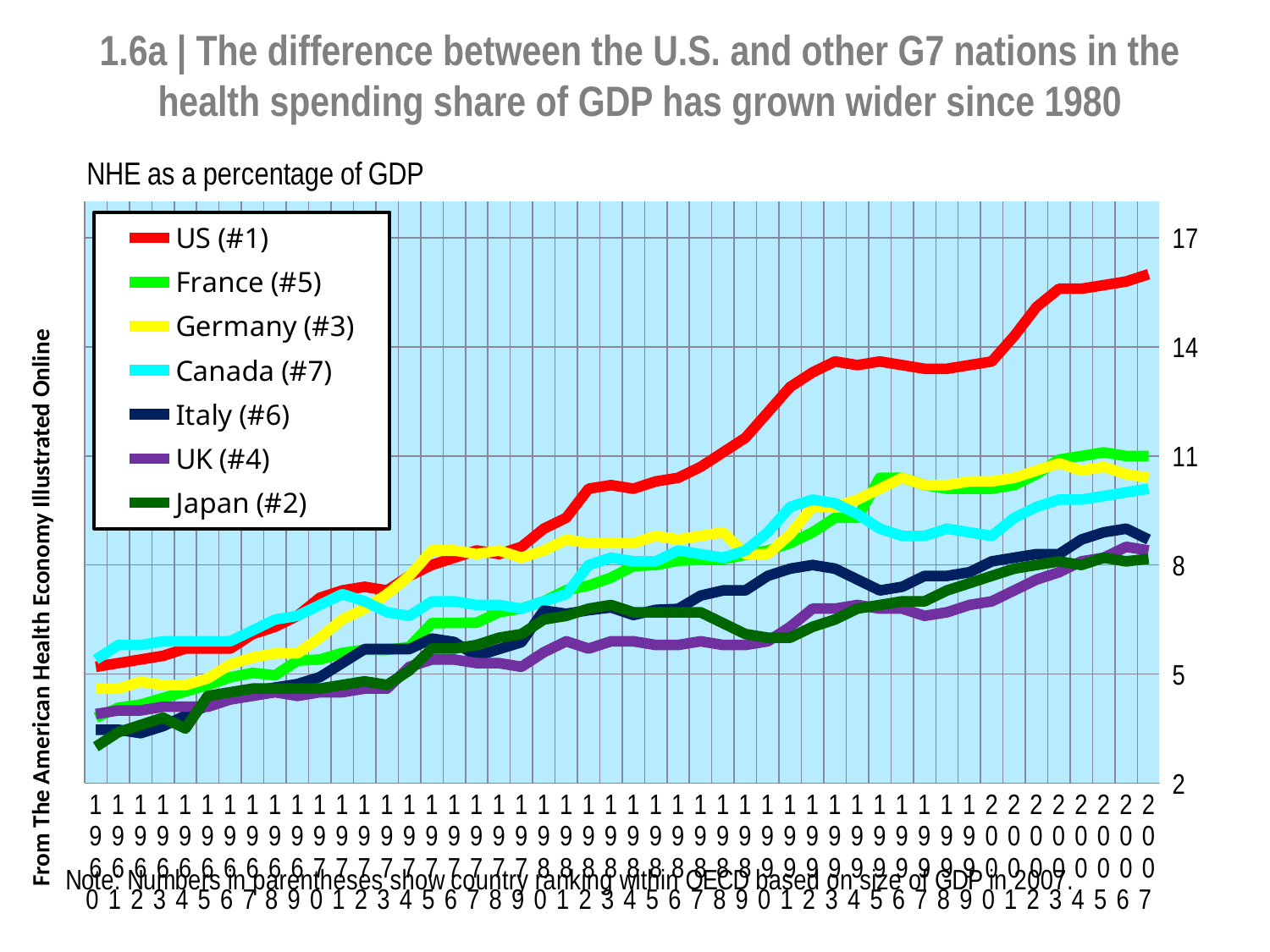
Is the value for Canada in 2007 greater or less than 8? greater Is the value for France in 1960 greater or less than 5? less Which is larger in 2007, the value for the US or the value for Canada? US What kind of chart is shown on the slide? line chart Which country has the lowest NHE as a percentage of GDP in 1960? Japan Does the US line rise or fall from 1960 to 2007? rise Is the value for Japan in 1960 greater or less than 5? less What OECD ranking is shown in parentheses next to Japan in the legend? #2 Which country has the highest NHE as a percentage of GDP in 2007? US How many series does the legend list? 7 What is the first year shown on the x axis? 1960